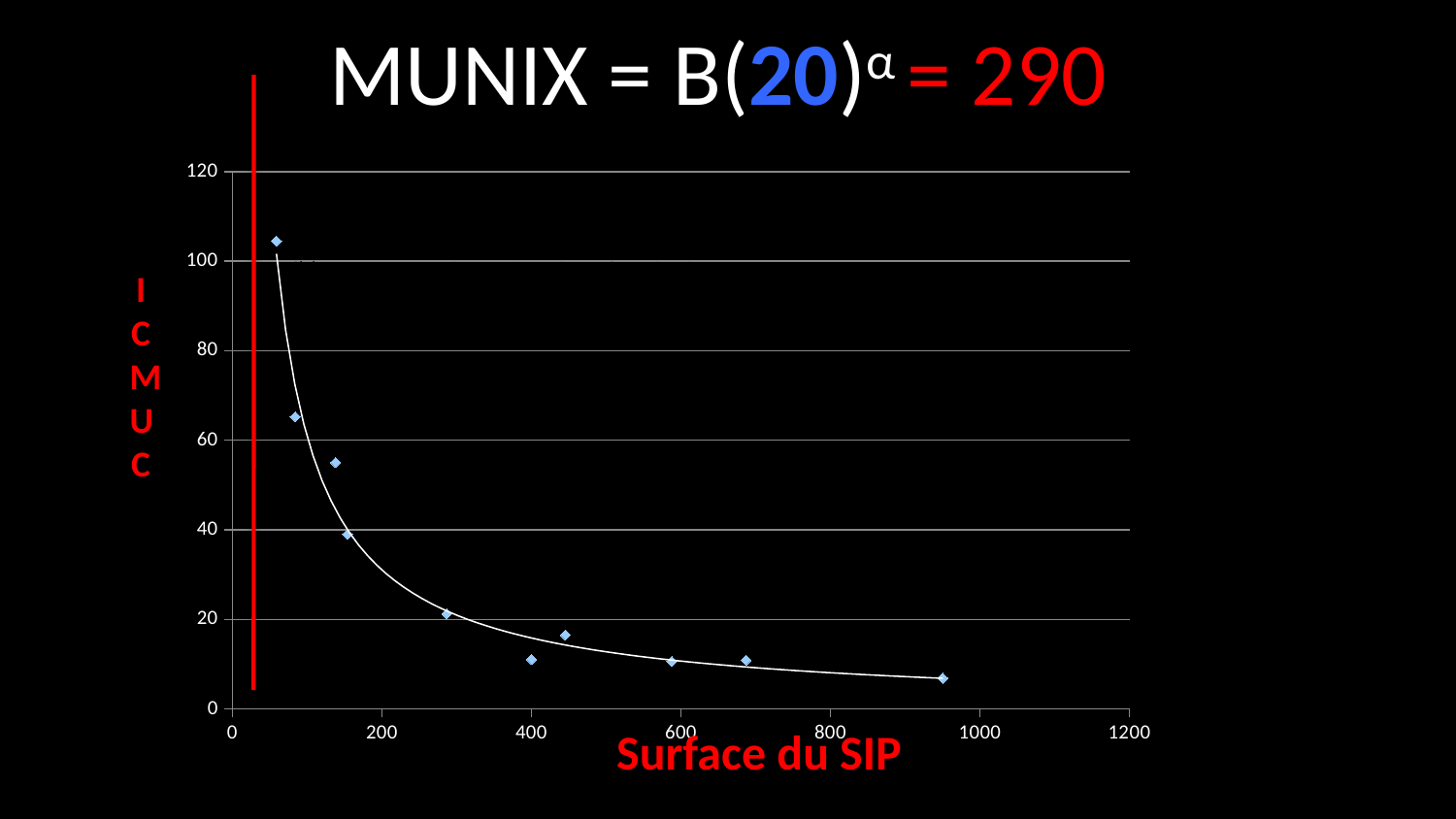
Which data point has the highest ICMUC value, the leftmost or the rightmost? the leftmost What is the highest value shown on the y axis? 120 How many data points are plotted on the chart? 10 What is the label of the y axis? ICMUC Is the ICMUC value of the data point near Surface du SIP 80 greater or less than 60? greater Do the ICMUC values rise or fall as Surface du SIP increases along the x axis? fall Is the ICMUC value of the data point near Surface du SIP 150 greater or less than 60? less Is the ICMUC value of the rightmost data point greater or less than 20? less What kind of chart is shown on the slide? scatter chart What is the label of the x axis? Surface du SIP